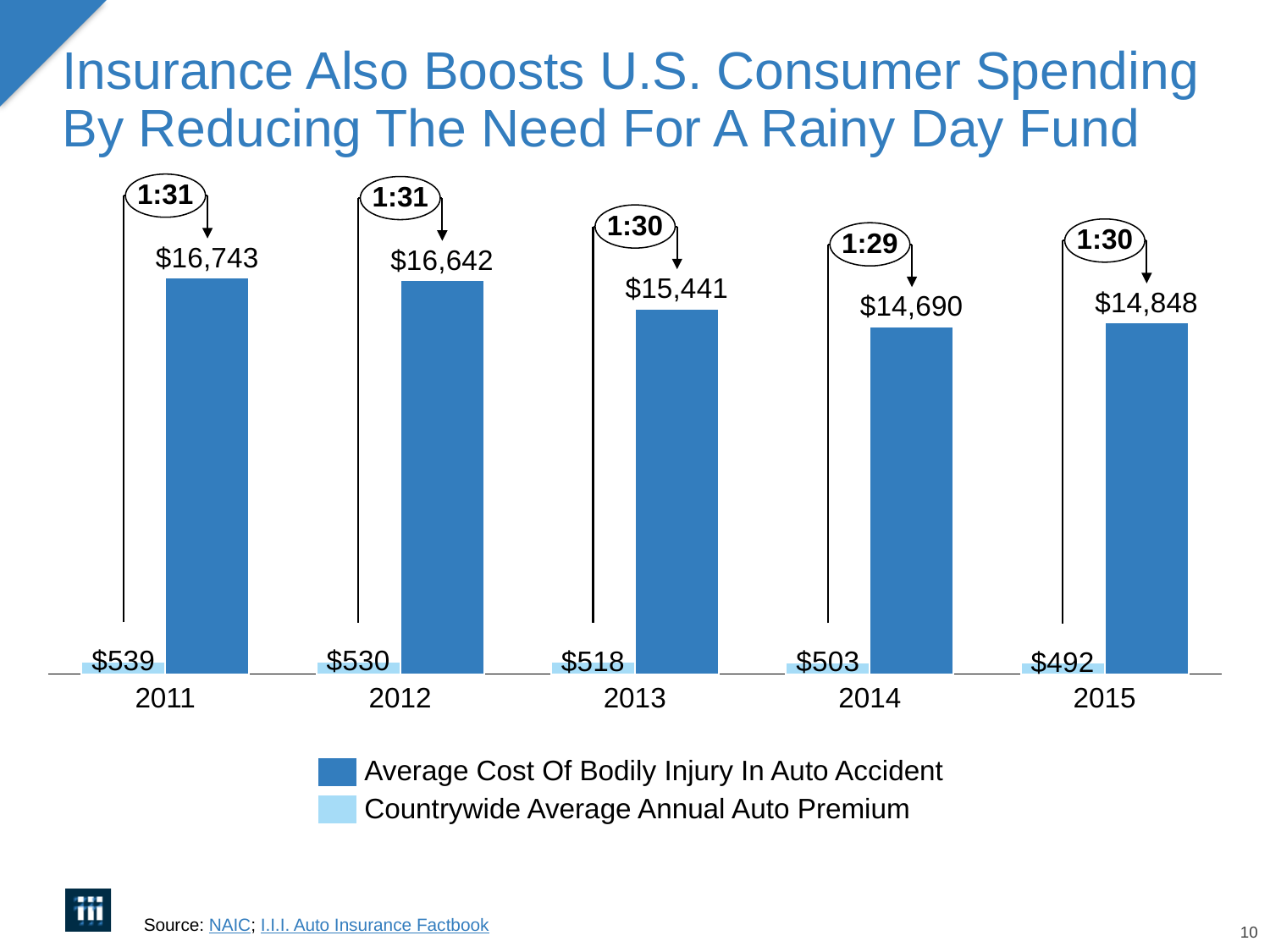
What ratio is shown in the circle above the 2014 bars? 1:29 How many years are shown on the x axis of the chart? 5 What is the difference between the Average Cost Of Bodily Injury In Auto Accident in 2011 and in 2012? $101 What was the Average Cost Of Bodily Injury In Auto Accident in 2013? $15,441 Which year had a higher Average Cost Of Bodily Injury In Auto Accident, 2014 or 2015? 2015 Does the Countrywide Average Annual Auto Premium rise or fall from 2011 to 2015? Fall What was the Countrywide Average Annual Auto Premium in 2015? $492 How many series does the legend list? 2 In which year was the Countrywide Average Annual Auto Premium lowest? 2015 What is the difference between the Countrywide Average Annual Auto Premium in 2011 and in 2015? $47 In which year was the Average Cost Of Bodily Injury In Auto Accident highest? 2011 What kind of chart is shown on the slide? Bar chart